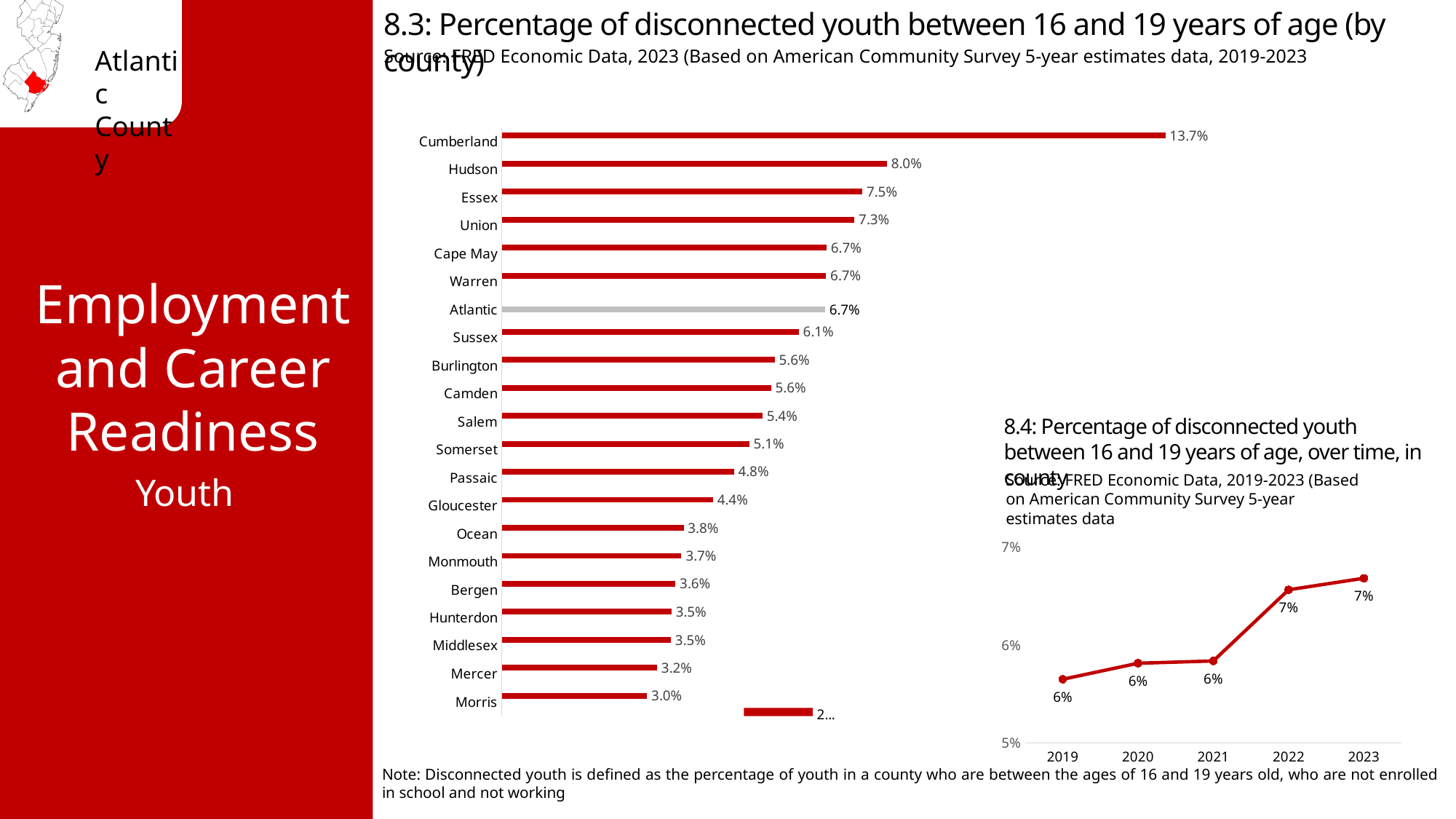
In chart 8.3 (by county), which county has a larger value, Essex or Union? Essex In chart 8.4 (over time), what is the value shown for 2023? 7% In chart 8.3 (by county), which county's bar is shown in grey rather than red? Atlantic In chart 8.3 (by county), which labeled county has the lowest percentage of disconnected youth? Morris In chart 8.3 (by county), what is the percentage of disconnected youth for Atlantic? 6.7% In chart 8.4 (over time), how many years are plotted? 5 In chart 8.4 (over time), do the values rise or fall from 2019 to 2023? Rise In chart 8.3 (by county), what is the difference between Cumberland's value and Hudson's value? 5.7% In chart 8.3 (by county), which county has the highest percentage of disconnected youth? Cumberland In chart 8.3 (by county), what is the value shown for Gloucester? 4.4% In chart 8.3 (by county), what kind of chart is used? Bar chart In chart 8.3 (by county), what is the percentage of disconnected youth for Cumberland? 13.7%